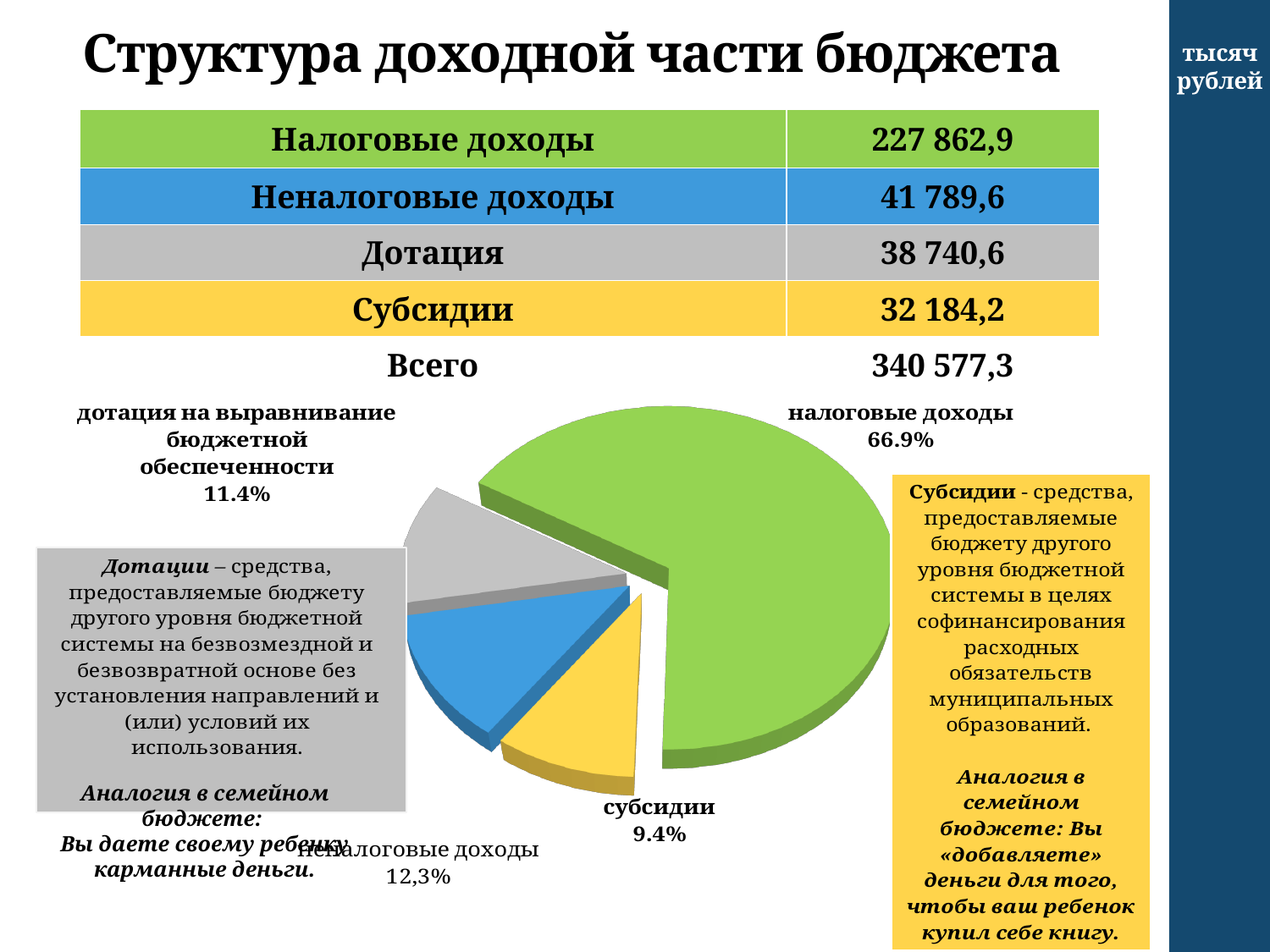
What share of the pie is labelled for дотация на выравнивание бюджетной обеспеченности? 11.4% Which slice of the pie chart is the smallest? субсидии What kind of chart is shown on the slide? pie chart Which slice is larger: неналоговые доходы or субсидии? неналоговые доходы What share of the pie is labelled for субсидии? 9.4% What share of the pie is labelled for неналоговые доходы? 12,3% How many slices does the pie chart have? 4 What colour is the slice for налоговые доходы in the pie chart? green Is the share for налоговые доходы greater or less than 50%? greater What colour is the slice for субсидии in the pie chart? yellow Which slice of the pie chart is the largest? налоговые доходы